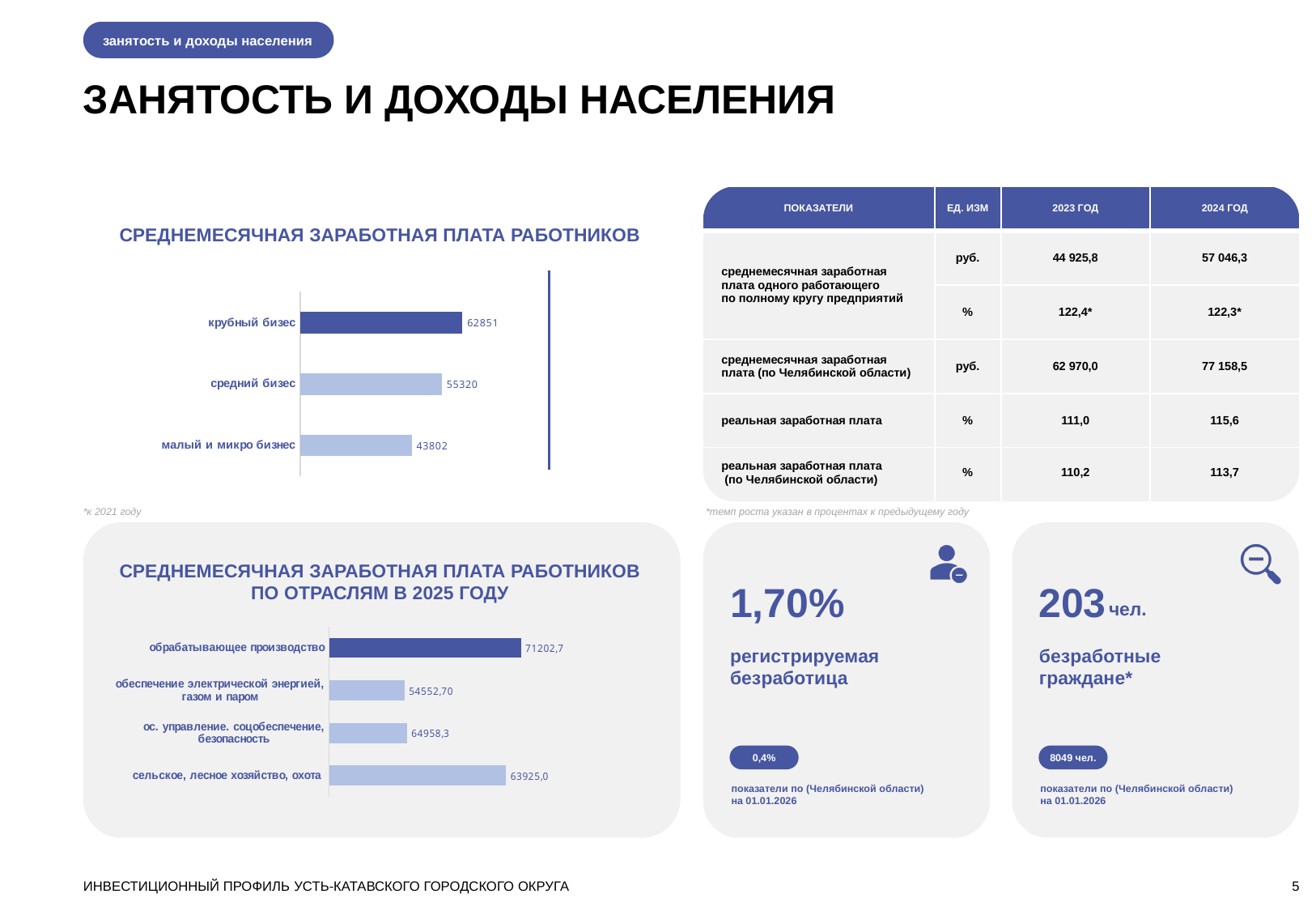
In the chart 'СРЕДНЕМЕСЯЧНАЯ ЗАРАБОТНАЯ ПЛАТА РАБОТНИКОВ' (top left), how many categories are shown? 3 In the chart 'СРЕДНЕМЕСЯЧНАЯ ЗАРАБОТНАЯ ПЛАТА РАБОТНИКОВ ПО ОТРАСЛЯМ В 2025 ГОДУ' (bottom left), how many categories are shown? 4 In the chart 'СРЕДНЕМЕСЯЧНАЯ ЗАРАБОТНАЯ ПЛАТА РАБОТНИКОВ ПО ОТРАСЛЯМ В 2025 ГОДУ' (bottom left), which bar is drawn in a darker blue than the others? обрабатывающее производство In the chart 'СРЕДНЕМЕСЯЧНАЯ ЗАРАБОТНАЯ ПЛАТА РАБОТНИКОВ ПО ОТРАСЛЯМ В 2025 ГОДУ' (bottom left), which is larger: 'обрабатывающее производство' or 'ос. управление. соцобеспечение, безопасность'? обрабатывающее производство In the chart 'СРЕДНЕМЕСЯЧНАЯ ЗАРАБОТНАЯ ПЛАТА РАБОТНИКОВ' (top left), which category has the highest value? крубный бизес In the chart 'СРЕДНЕМЕСЯЧНАЯ ЗАРАБОТНАЯ ПЛАТА РАБОТНИКОВ ПО ОТРАСЛЯМ В 2025 ГОДУ' (bottom left), what is the value for 'обрабатывающее производство'? 71202,7 What type of chart is 'СРЕДНЕМЕСЯЧНАЯ ЗАРАБОТНАЯ ПЛАТА РАБОТНИКОВ' (top left)? bar chart In the chart 'СРЕДНЕМЕСЯЧНАЯ ЗАРАБОТНАЯ ПЛАТА РАБОТНИКОВ ПО ОТРАСЛЯМ В 2025 ГОДУ' (bottom left), which category has the lowest labelled value? обеспечение электрической энергией, газом и паром In the chart 'СРЕДНЕМЕСЯЧНАЯ ЗАРАБОТНАЯ ПЛАТА РАБОТНИКОВ' (top left), what is the value for 'средний бизес'? 55320 In the chart 'СРЕДНЕМЕСЯЧНАЯ ЗАРАБОТНАЯ ПЛАТА РАБОТНИКОВ' (top left), what is the difference between 'крубный бизес' and 'малый и микро бизнес'? 19049 In the chart 'СРЕДНЕМЕСЯЧНАЯ ЗАРАБОТНАЯ ПЛАТА РАБОТНИКОВ ПО ОТРАСЛЯМ В 2025 ГОДУ' (bottom left), what is the value for 'сельское, лесное хозяйство, охота'? 63925,0 In the chart 'СРЕДНЕМЕСЯЧНАЯ ЗАРАБОТНАЯ ПЛАТА РАБОТНИКОВ' (top left), which category has the lowest value? малый и микро бизнес